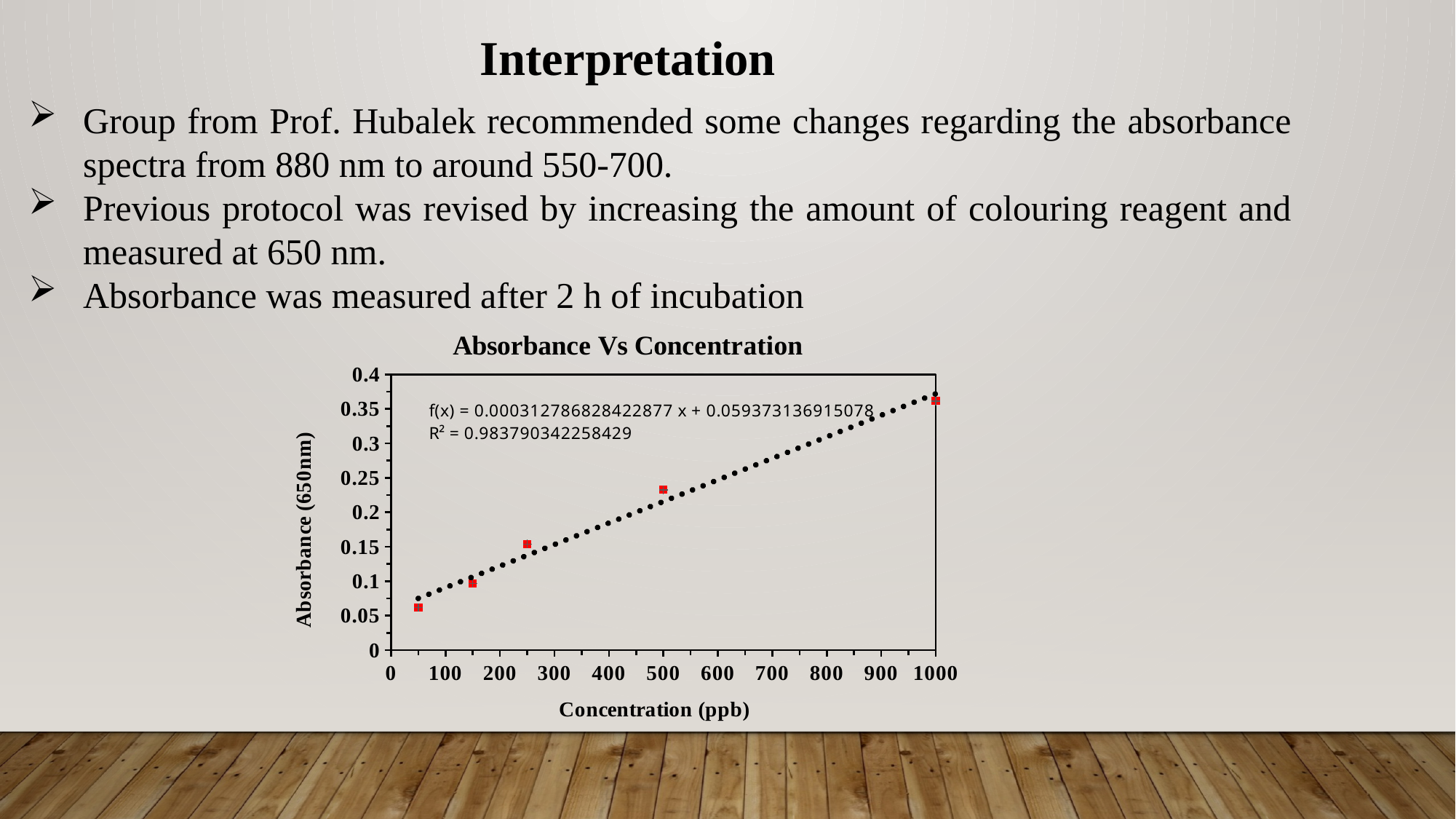
Do the absorbance values rise or fall as concentration increases along the x axis? rise Is the absorbance value at 50 ppb greater or less than 0.1? less What is the trendline equation shown on the chart? f(x) = 0.000312786828422877 x + 0.059373136915078 What kind of chart is shown on the slide? scatter chart How many data points are plotted in the chart? 5 Is the absorbance value at 1000 ppb greater or less than 0.3? greater What is the R² value shown on the chart? 0.983790342258429 Is the absorbance value at 250 ppb greater or less than 0.1? greater What is the label of the y axis of the chart? Absorbance (650nm) What is the title of the chart? Absorbance Vs Concentration Which data point has the highest absorbance? 1000 ppb